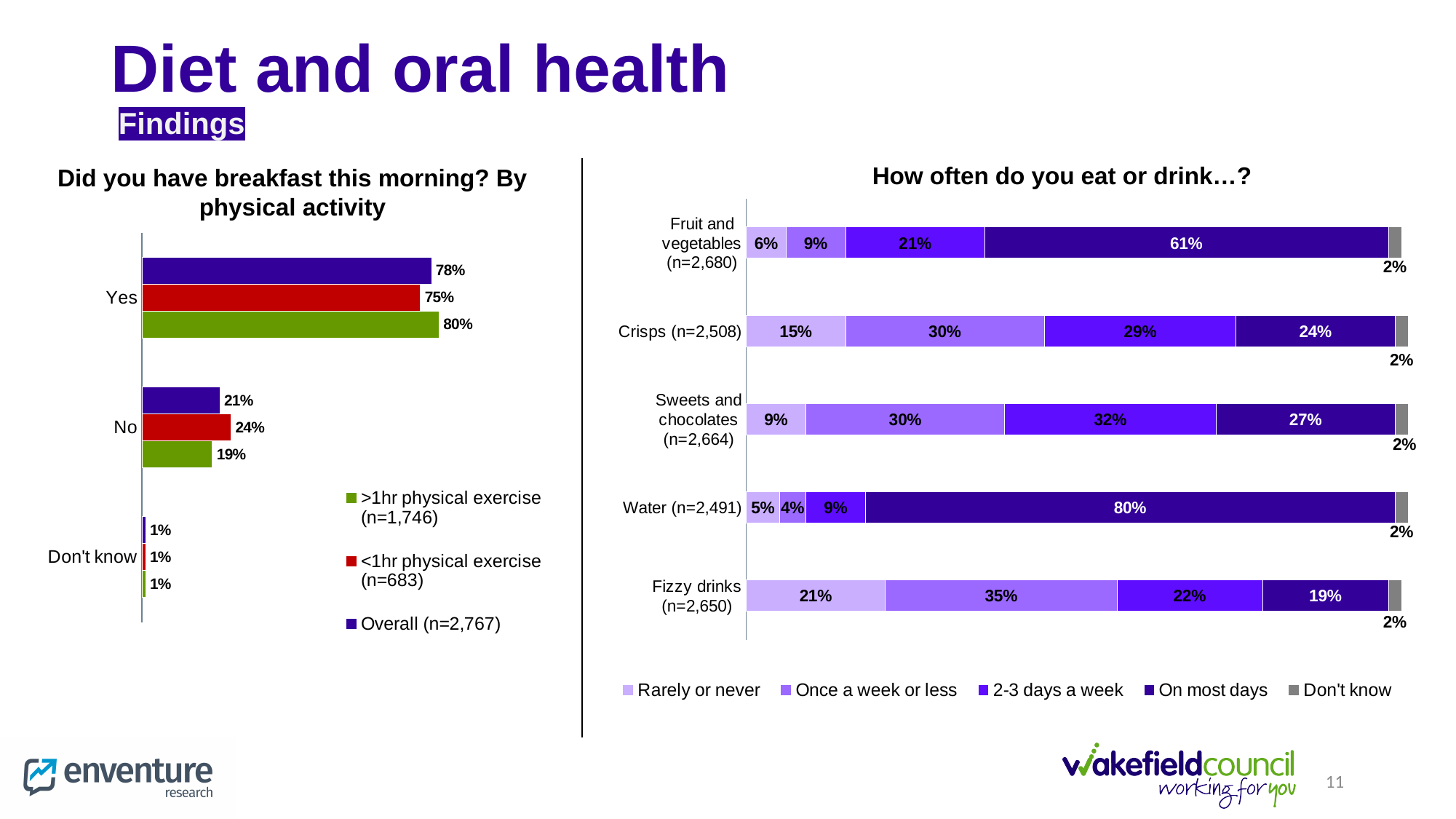
In the 'How often do you eat or drink…?' chart, how many categories are shown? 5 In the 'Did you have breakfast this morning? By physical activity' chart, what is the difference between the >1hr physical exercise and <1hr physical exercise values for 'Yes'? 5% In the 'Did you have breakfast this morning? By physical activity' chart, what is the value for 'Yes' in the Overall (n=2,767) series? 78% What kind of chart is 'How often do you eat or drink…?'? Stacked bar chart In the 'How often do you eat or drink…?' chart, what is the 'On most days' value for Water (n=2,491)? 80% In the 'Did you have breakfast this morning? By physical activity' chart, how many series does the legend list? 3 In the 'Did you have breakfast this morning? By physical activity' chart, what is the value for 'No' in the <1hr physical exercise (n=683) series? 24% In the 'Did you have breakfast this morning? By physical activity' chart, which series has the highest value for 'No'? <1hr physical exercise (n=683) In the 'How often do you eat or drink…?' chart, what is the 'Rarely or never' value for Fizzy drinks (n=2,650)? 21% In the 'How often do you eat or drink…?' chart, is the '2-3 days a week' value for Sweets and chocolates (n=2,664) larger or smaller than that for Crisps (n=2,508)? Larger In the 'How often do you eat or drink…?' chart, which category has the lowest 'On most days' value? Fizzy drinks (n=2,650) In the 'How often do you eat or drink…?' chart, which category has the highest 'On most days' value? Water (n=2,491)